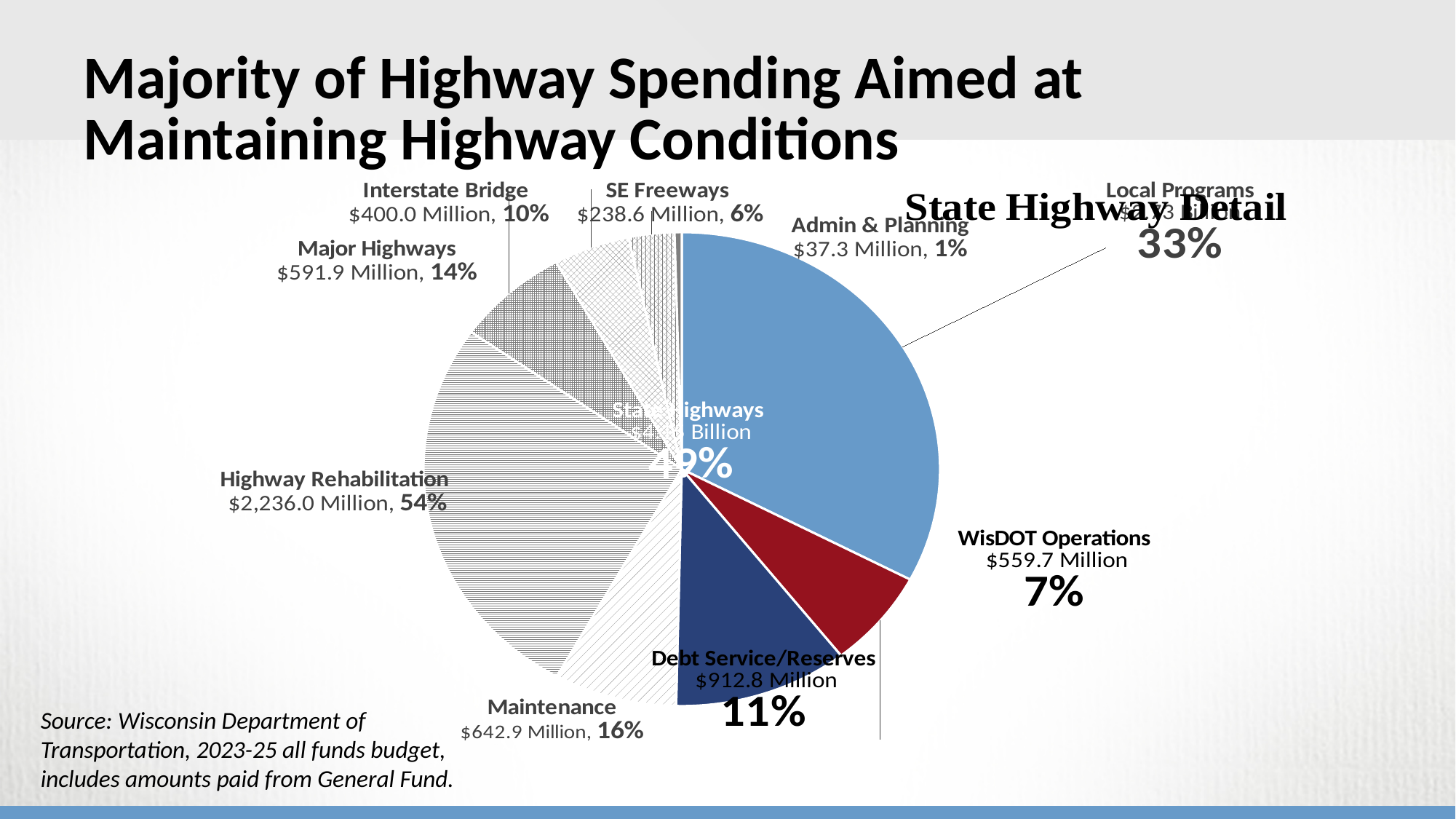
In the State Highway Detail chart, which category has the largest share? Highway Rehabilitation What kind of chart is used on this slide? Pie chart In the overall highway spending pie chart, what percentage share does WisDOT Operations have? 7% In the overall highway spending pie chart, what percentage share does Local Programs have? 33% In the State Highway Detail chart, what is the value for Major Highways? $591.9 Million In the State Highway Detail chart, what percentage share does Maintenance have? 16% In the overall highway spending pie chart, what is the value for Debt Service/Reserves? $912.8 Million In the State Highway Detail chart, what is the difference between the Interstate Bridge value and the SE Freeways value? $161.4 Million In the State Highway Detail chart, what is the value for Highway Rehabilitation? $2,236.0 Million In the State Highway Detail chart, what is the value for SE Freeways? $238.6 Million In the State Highway Detail chart, which category has the smallest share? Admin & Planning In the State Highway Detail chart, which is larger, Maintenance or Major Highways? Maintenance